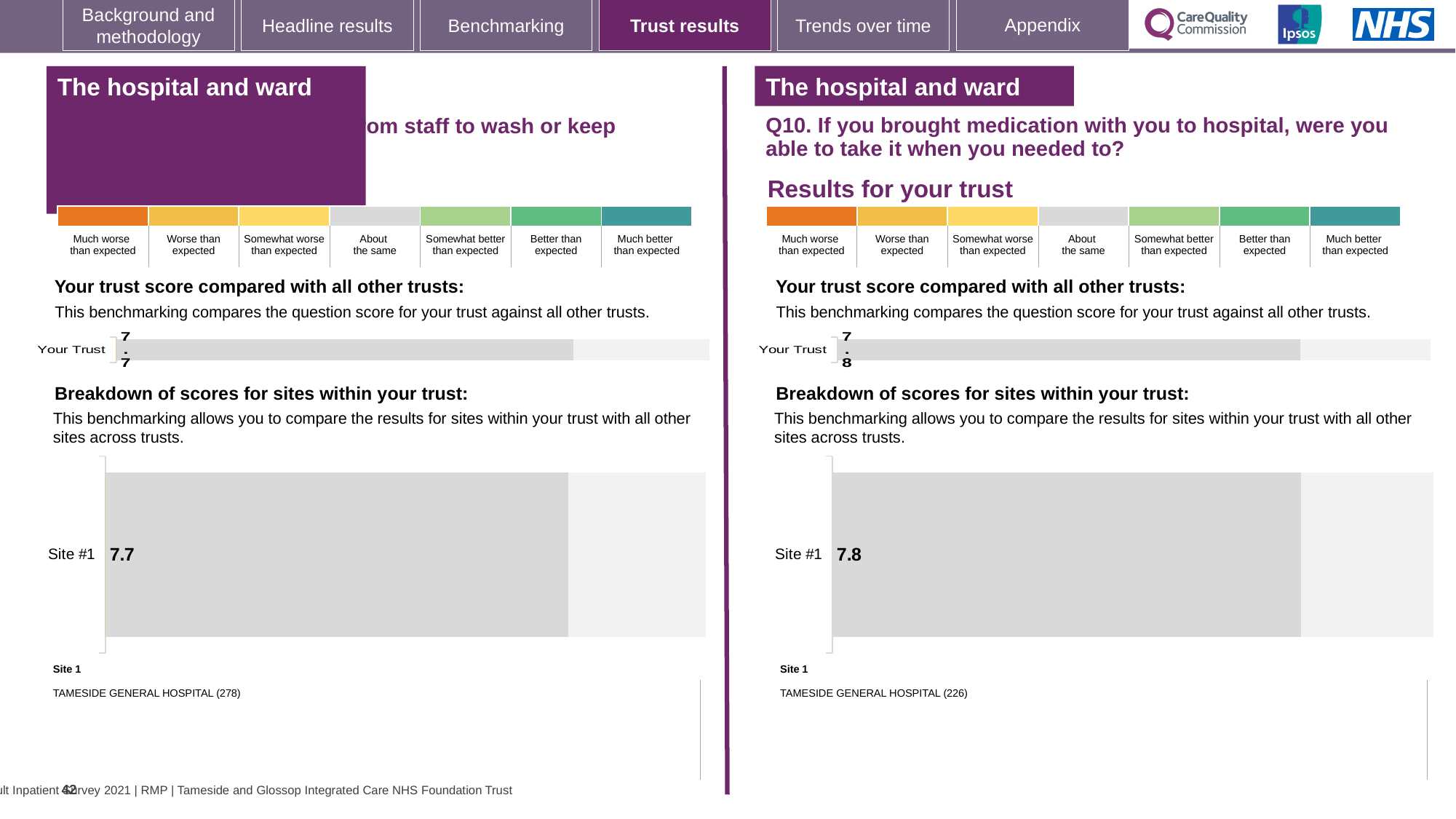
Which is larger: the Site #1 score on the left-hand side of the slide or the Site #1 score on the right-hand side (Q10)? Right-hand side (Q10), 7.8 On the right-hand side of the slide (Q10, medication), what is the score shown for Your Trust? 7.8 On the right-hand side of the slide (Q10, medication), what is the score shown for Site #1? 7.8 On the left-hand side of the slide, what is the score shown for Your Trust? 7.7 What is the difference between the Site #1 score on the right-hand side (Q10) and the Site #1 score on the left-hand side of the slide? 0.1 On the left-hand side of the slide, which hospital is listed as Site 1? TAMESIDE GENERAL HOSPITAL (278) On the right-hand side of the slide (Q10), is the Your Trust score greater or less than the Site #1 score, or are they equal? Equal What kind of chart is used to show the Site #1 score on the right-hand side of the slide (Q10)? Bar chart How many sites are shown in the 'Breakdown of scores for sites within your trust' chart on the right-hand side of the slide (Q10)? 1 On the left-hand side of the slide, what is the score shown for Site #1? 7.7 How many sites are shown in the 'Breakdown of scores for sites within your trust' chart on the left-hand side of the slide? 1 On the right-hand side of the slide (Q10), which hospital is listed as Site 1? TAMESIDE GENERAL HOSPITAL (226)